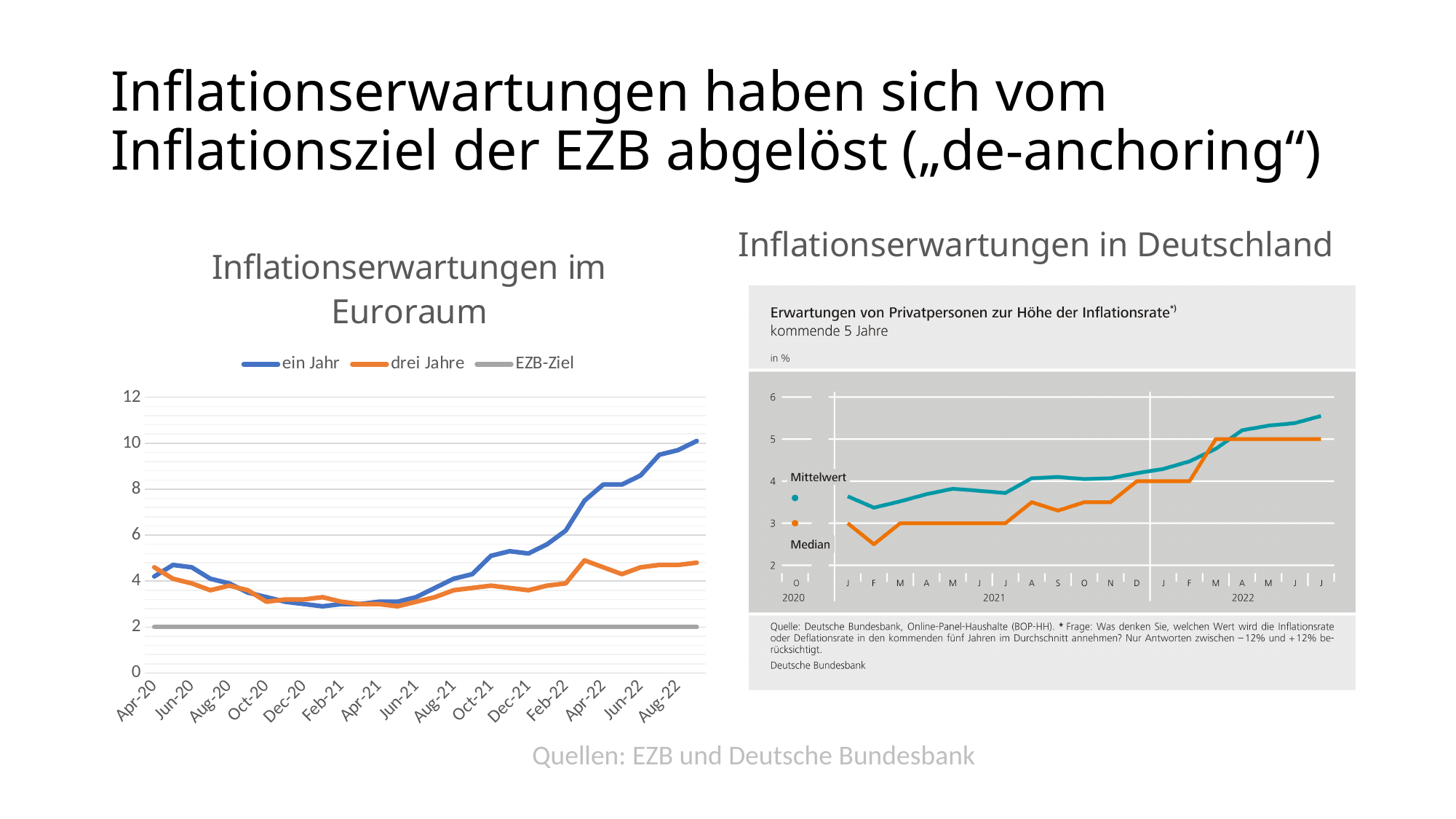
How many series are shown in the "Inflationserwartungen in Deutschland" chart? 2 In the "Inflationserwartungen in Deutschland" chart, which series is higher at the last point (J 2022), Mittelwert or Median? Mittelwert How many series does the legend of the "Inflationserwartungen im Euroraum" chart list? 3 What kind of chart is the "Inflationserwartungen im Euroraum" chart? line chart In the "Inflationserwartungen in Deutschland" chart, is the Median value at F 2021 greater or less than 3? less In the "Inflationserwartungen im Euroraum" chart, which series is higher at Aug-22, ein Jahr or drei Jahre? ein Jahr In the "Inflationserwartungen im Euroraum" chart, which colour is the ein Jahr line? blue In the "Inflationserwartungen im Euroraum" chart, does the ein Jahr line rise or fall from Jun-21 to Aug-22? rise What kind of chart is the "Inflationserwartungen in Deutschland" chart? line chart In the "Inflationserwartungen im Euroraum" chart, is the value of drei Jahre at Aug-22 greater or less than 6? less In the "Inflationserwartungen im Euroraum" chart, what value does the EZB-Ziel line sit at? 2 In the "Inflationserwartungen im Euroraum" chart, is the value of ein Jahr at Aug-22 greater or less than 8? greater